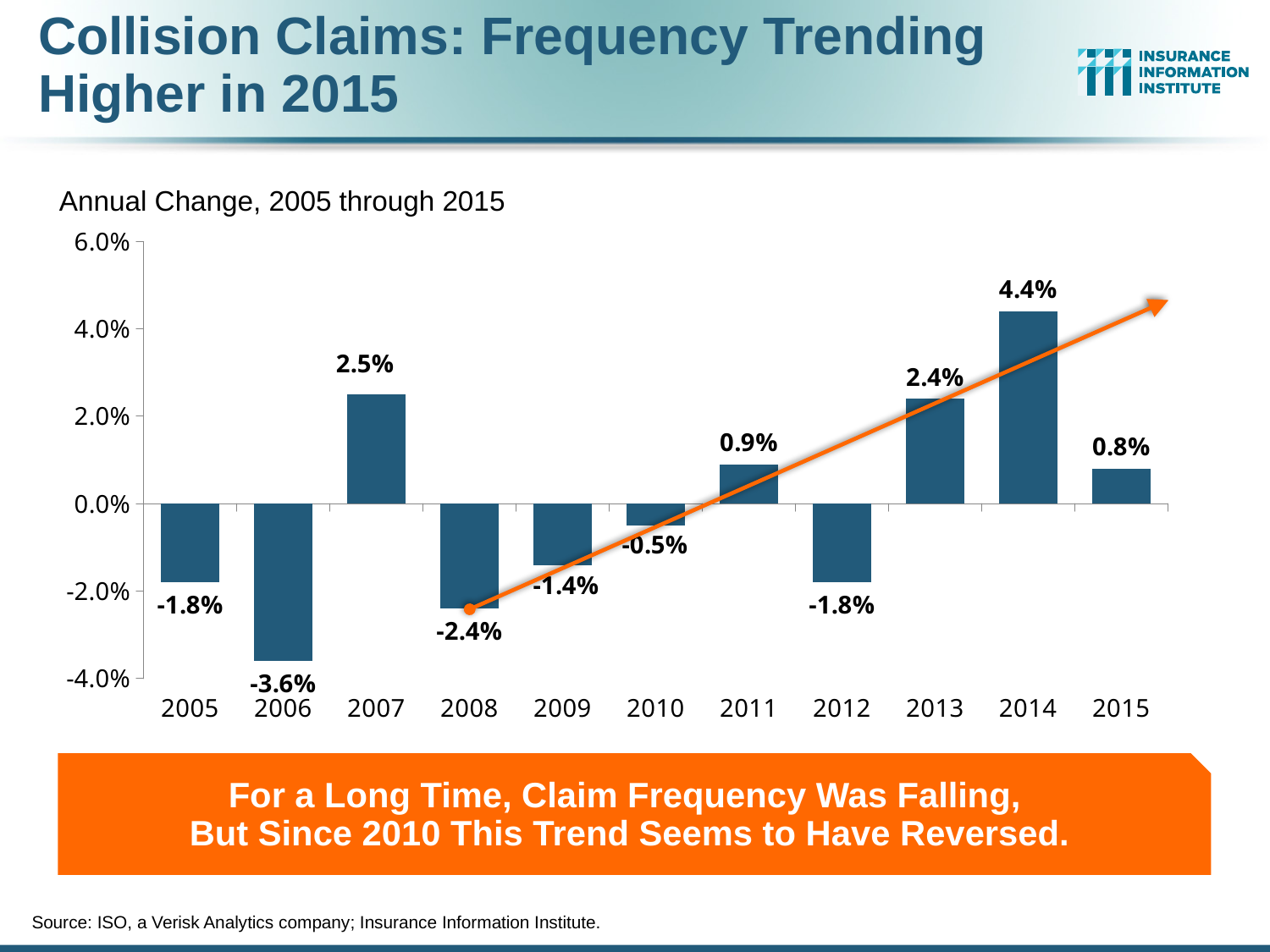
How many years are shown on the x axis of the chart? 11 Which year shows the highest annual change in collision claim frequency? 2014 What kind of chart is used to show the annual change in collision claim frequency? Bar chart From 2012 to 2014, do the annual change values rise or fall? Rise Is the value for 2008 greater or less than -2.0%? less Which year shows the lowest annual change in collision claim frequency? 2006 What is the difference between the annual change in 2014 and the annual change in 2013? 2.0 percentage points What was the annual change in collision claim frequency in 2010? -0.5% Which year had a larger annual change in collision claim frequency, 2007 or 2011? 2007 What was the annual change in collision claim frequency in 2006? -3.6% What was the annual change in collision claim frequency in 2014? 4.4% What is the subtitle printed above the chart? Annual Change, 2005 through 2015